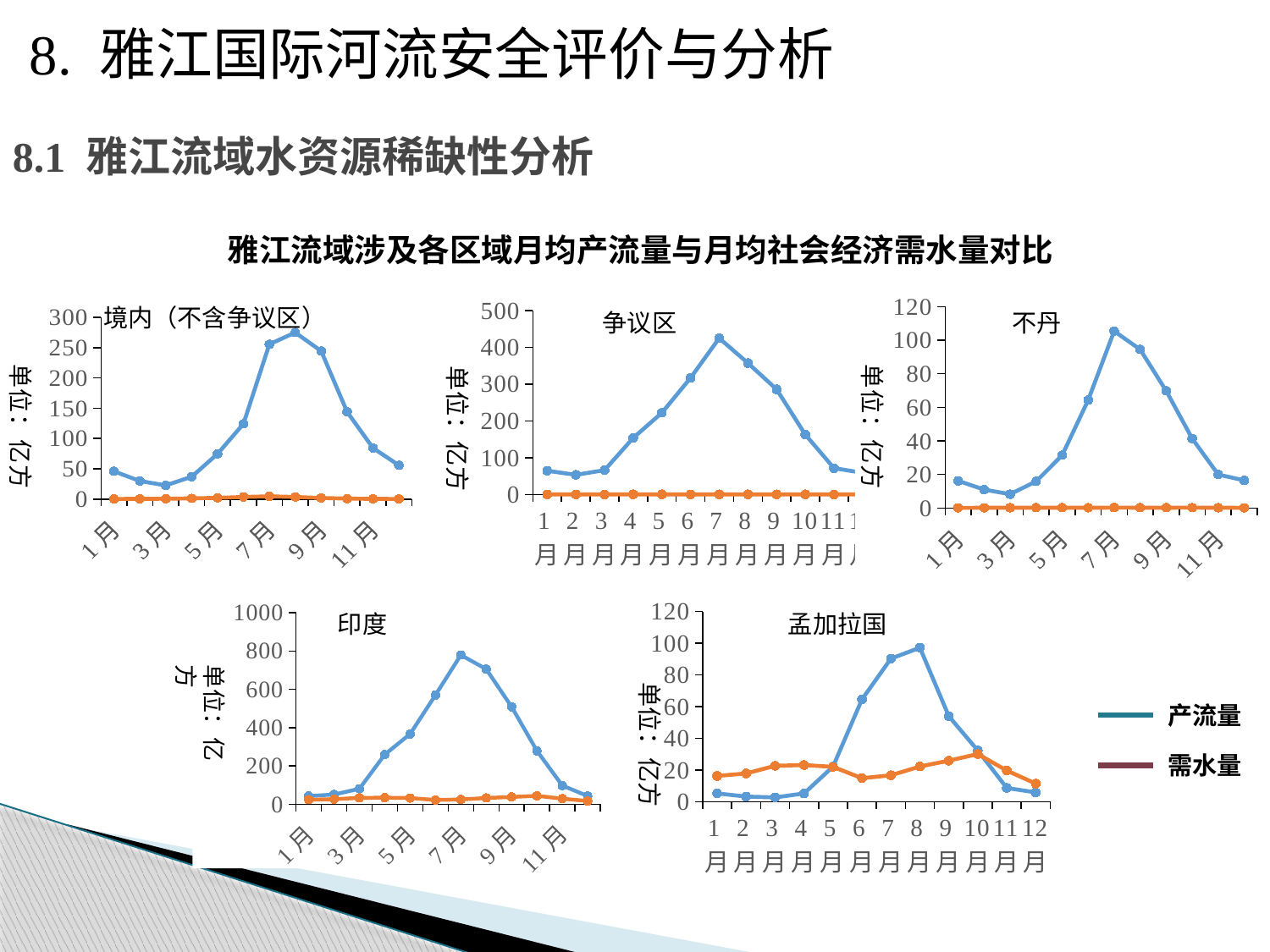
In the 孟加拉国 chart, which is larger in 4月, 产流量 or 需水量? 需水量 In the 不丹 chart, which month has the highest 产流量? 7月 What is the overall title shown above the five charts? 雅江流域涉及各区域月均产流量与月均社会经济需水量对比 In the 孟加拉国 chart, which month has the highest 产流量? 8月 What kind of chart is the 境内（不含争议区） chart? line chart In the 争议区 chart, which month has the highest 产流量? 7月 In the 印度 chart, does 产流量 rise or fall from 1月 to 7月? rise In the 争议区 chart, is the 产流量 value for 7月 greater or less than 400? greater In the 孟加拉国 chart, how many months are plotted along the x axis? 12 How many series does the legend list for the charts? 2